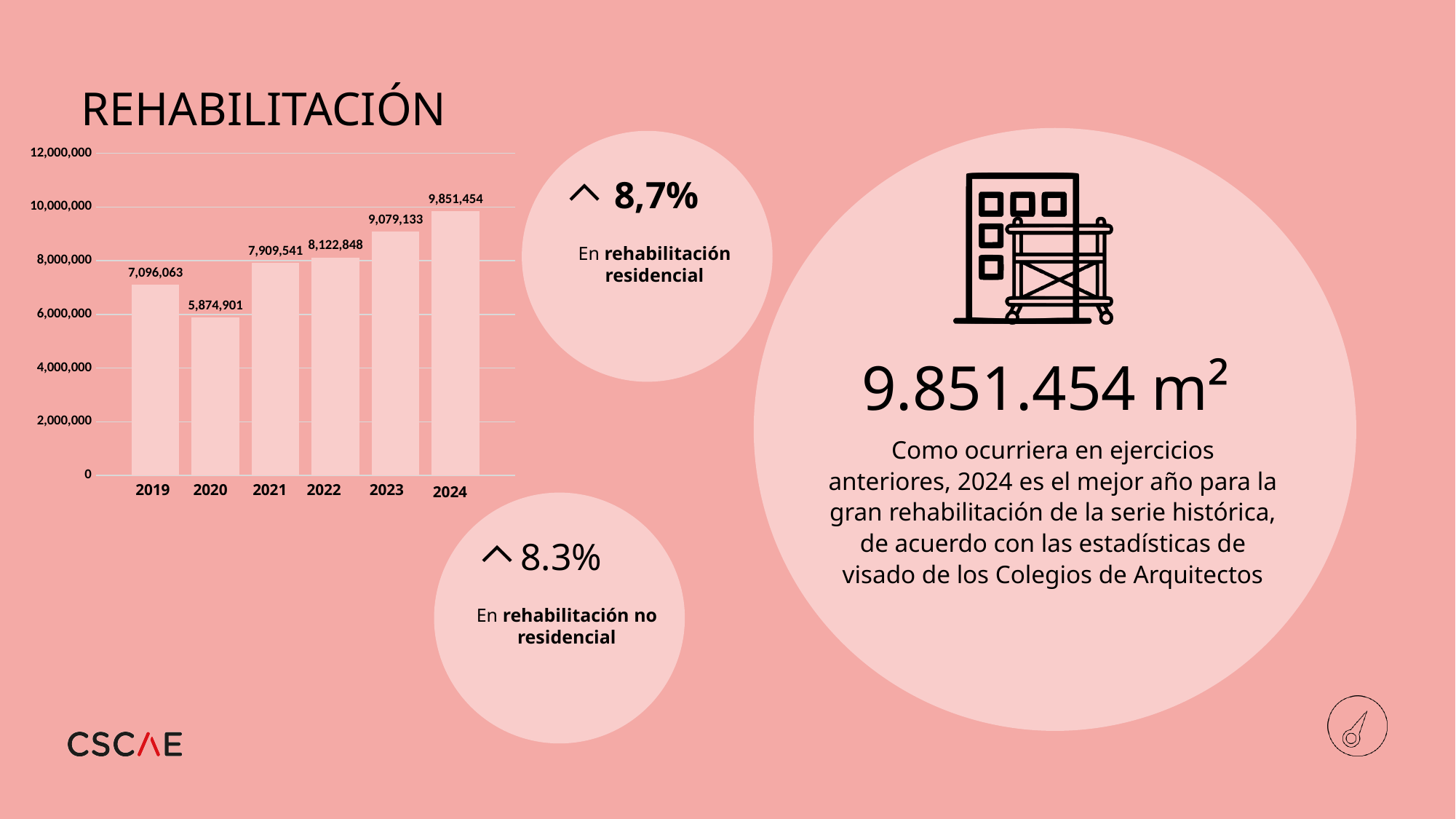
What is the value for 2022 in the bar chart? 8,122,848 Do the values rise or fall from 2020 to 2024? rise Which year has the lowest value in the bar chart? 2020 Is the value for 2023 greater or less than 8,000,000? greater What is the value for 2024 in the bar chart? 9,851,454 What is the value for 2020 in the bar chart? 5,874,901 Which is larger, the value for 2021 or the value for 2022? 2022 How many years are shown in the bar chart? 6 What is the difference between the values for 2019 and 2020? 1,221,162 What kind of chart is shown on the slide? bar chart Which year has the highest value in the bar chart? 2024 What is the difference between the values for 2024 and 2023? 772,321